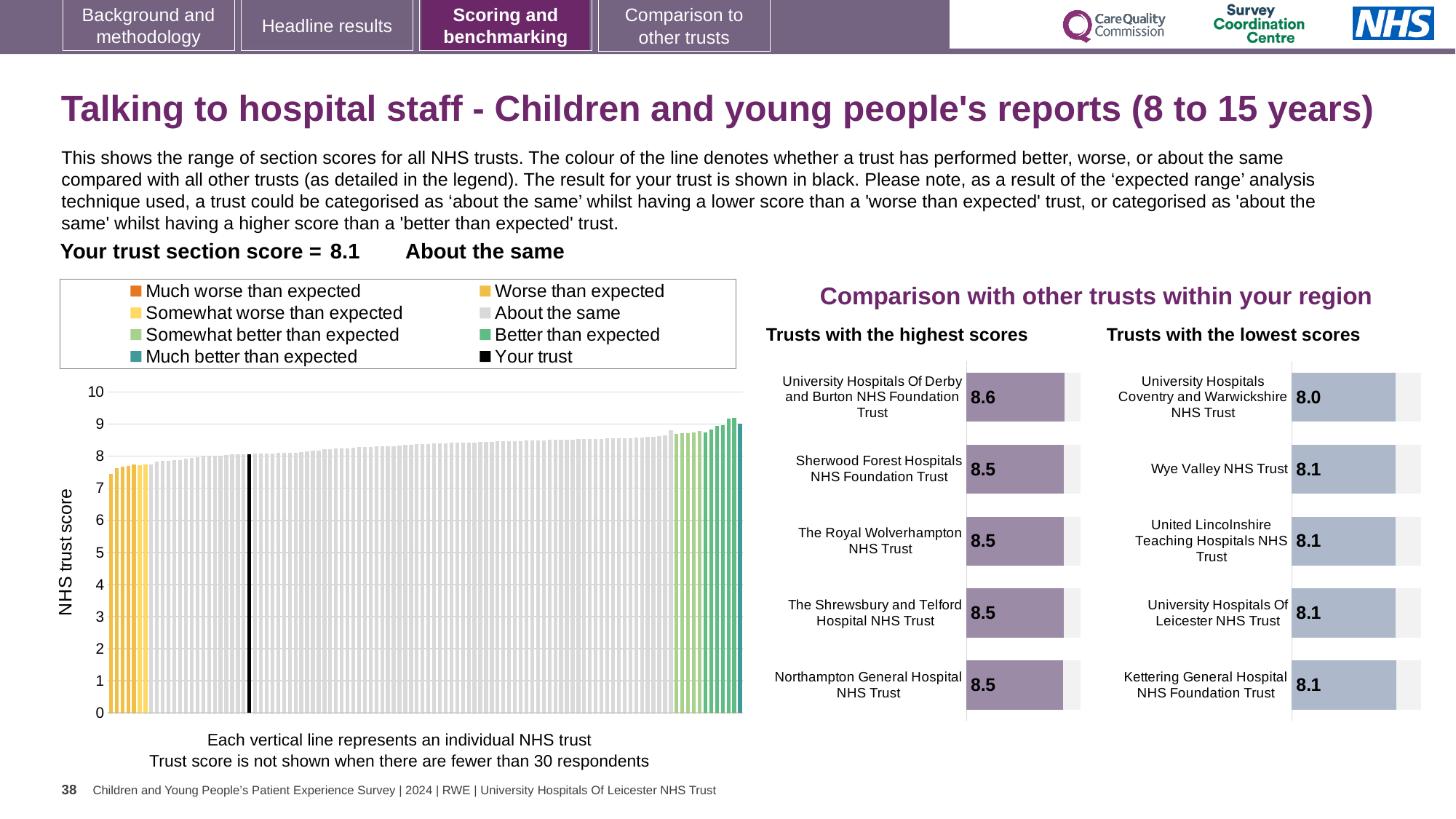
In the large 'NHS trust score' chart, do the bar values rise or fall from left to right? Rise In the 'Trusts with the lowest scores' chart, what is the score for Kettering General Hospital NHS Foundation Trust? 8.1 Which is larger: the score for University Hospitals Of Derby and Burton NHS Foundation Trust in the highest scores chart, or the score for Wye Valley NHS Trust in the lowest scores chart? University Hospitals Of Derby and Burton NHS Foundation Trust In the 'Trusts with the lowest scores' chart, what is the score for University Hospitals Coventry and Warwickshire NHS Trust? 8.0 In the 'Trusts with the highest scores' chart, what is the score for University Hospitals Of Derby and Burton NHS Foundation Trust? 8.6 In the 'Trusts with the lowest scores' chart, which trust has the lowest score? University Hospitals Coventry and Warwickshire NHS Trust In the 'Trusts with the highest scores' chart, what is the score for Northampton General Hospital NHS Trust? 8.5 What kind of chart is the large chart on the left with the y-axis labelled 'NHS trust score'? Bar chart In the 'Trusts with the highest scores' chart, what is the difference between the scores of University Hospitals Of Derby and Burton NHS Foundation Trust and Sherwood Forest Hospitals NHS Foundation Trust? 0.1 How many entries does the legend of the large 'NHS trust score' chart list? 8 How many trusts are listed in the 'Trusts with the lowest scores' chart? 5 In the 'Trusts with the highest scores' chart, which trust has the highest score? University Hospitals Of Derby and Burton NHS Foundation Trust